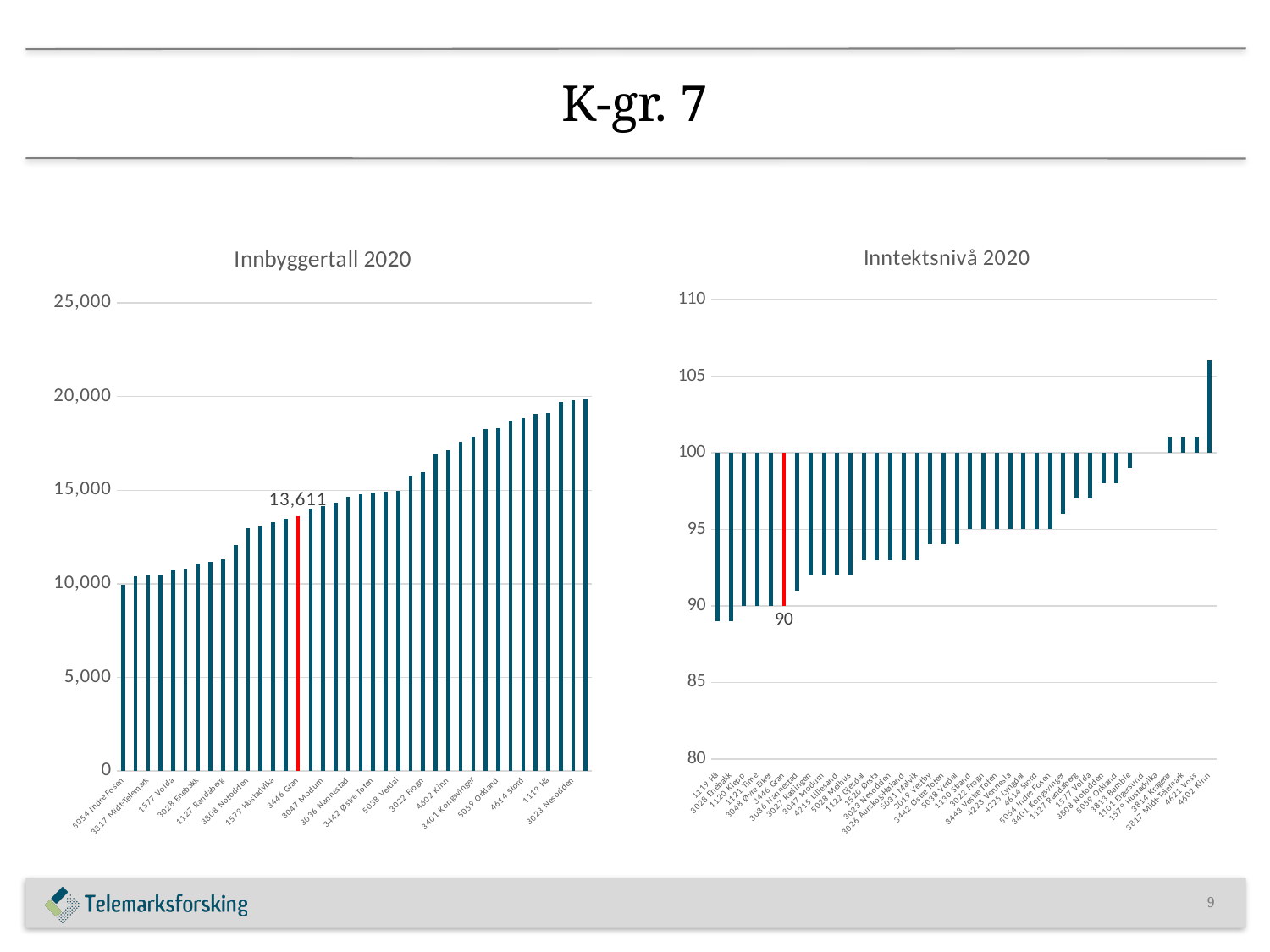
In the Inntektsnivå 2020 chart, do the values rise or fall from left to right along the x axis? rise In the Innbyggertall 2020 chart, what is the value for 3446 Gran? 13,611 In the Innbyggertall 2020 chart, which is larger, the value for 3023 Nesodden or the value for 5054 Indre Fosen? 3023 Nesodden In the Inntektsnivå 2020 chart, what is the value for 3446 Gran? 90 In the Inntektsnivå 2020 chart, which category has the lowest value? 1119 Hå and 3028 Enebakk (tied) In the Inntektsnivå 2020 chart, is the value for 1119 Hå greater or less than 95? less What kind of chart is the Innbyggertall 2020 chart? bar chart In the Innbyggertall 2020 chart, is the value for 3023 Nesodden greater or less than 15,000? greater In the Inntektsnivå 2020 chart, which category has the highest value? 4602 Kinn In the Inntektsnivå 2020 chart, is the value for 4602 Kinn greater or less than 105? greater In the Innbyggertall 2020 chart, which category has the lowest value? 5054 Indre Fosen